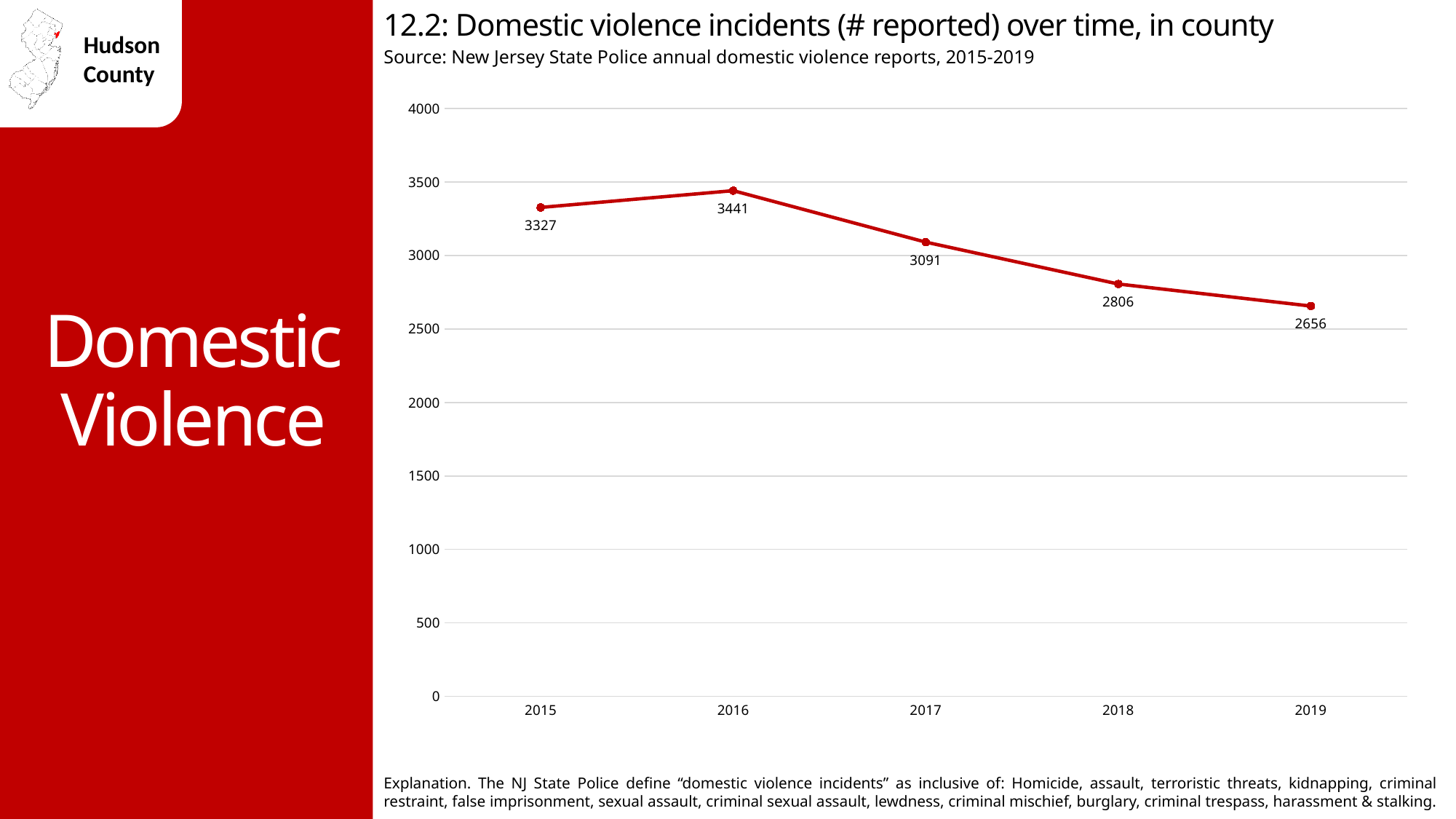
What was the number of reported domestic violence incidents in 2017? 3091 Is the value for 2018 greater or less than 3000? less What is the difference between the number of incidents in 2017 and in 2018? 285 How many years are plotted on the chart? 5 What was the number of reported domestic violence incidents in 2015? 3327 Which year had the lowest number of reported domestic violence incidents? 2019 What kind of chart is shown on the slide? line chart Which year had more reported incidents, 2015 or 2018? 2015 What was the number of reported domestic violence incidents in 2019? 2656 What is the difference between the number of incidents in 2016 and in 2019? 785 Which year had the highest number of reported domestic violence incidents? 2016 What is the overall trend in reported incidents from 2016 to 2019? falling